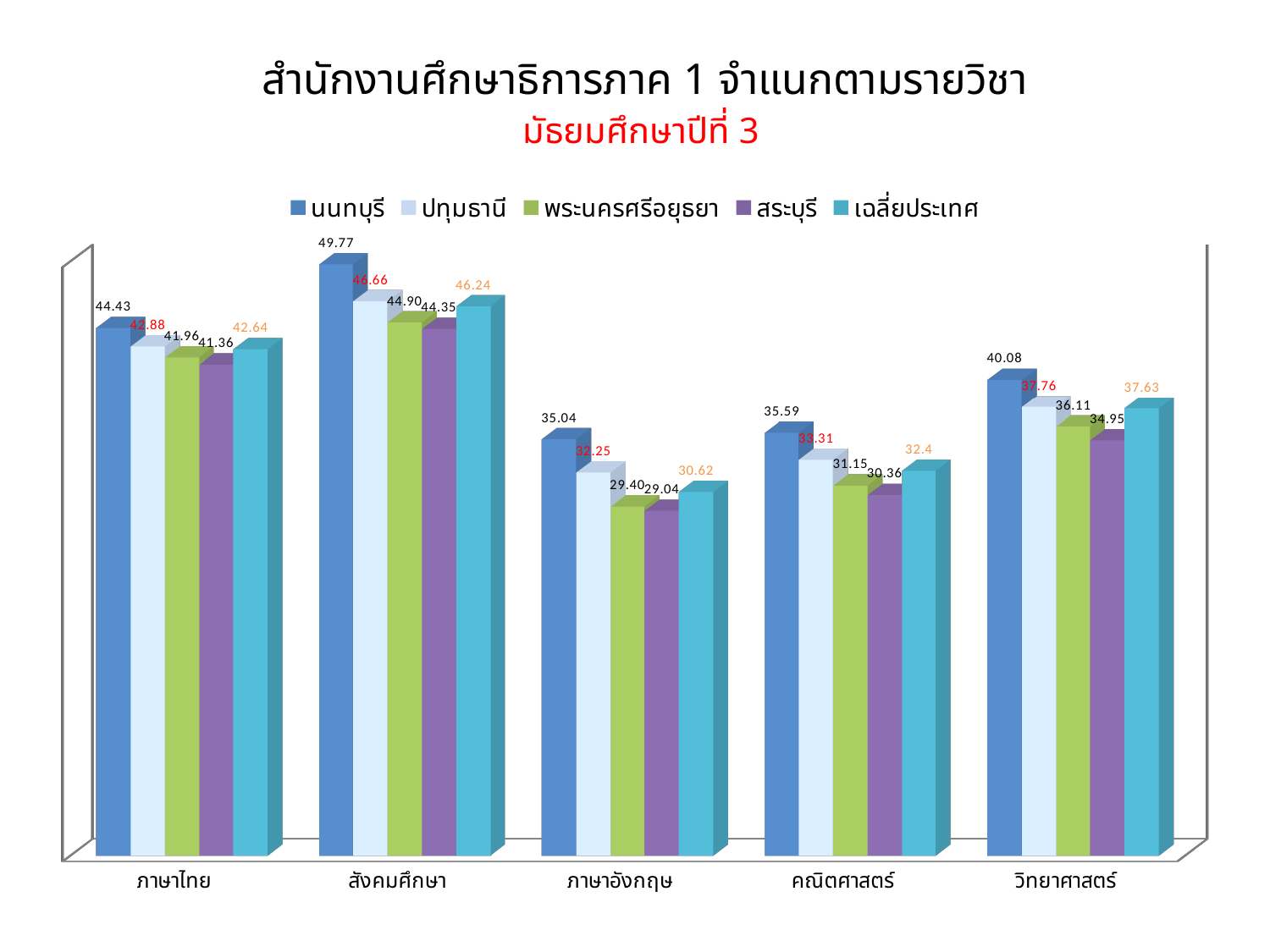
How many series does the legend list? 5 What is the difference between the นนทบุรี and สระบุรี values in ภาษาไทย? 3.07 How many subjects are shown on the x axis? 5 What is the value for สระบุรี in ภาษาอังกฤษ? 29.04 What is the red subtitle below the chart title? มัธยมศึกษาปีที่ 3 What is the value for เฉลี่ยประเทศ in คณิตศาสตร์? 32.4 Which subject has the highest value for นนทบุรี? สังคมศึกษา What is the value for พระนครศรีอยุธยา in วิทยาศาสตร์? 36.11 What kind of chart is shown on the slide? Bar chart What is the value for นนทบุรี in สังคมศึกษา? 49.77 Which is larger in วิทยาศาสตร์: the value for ปทุมธานี or the value for เฉลี่ยประเทศ? ปทุมธานี Which subject has the lowest value for ปทุมธานี? ภาษาอังกฤษ